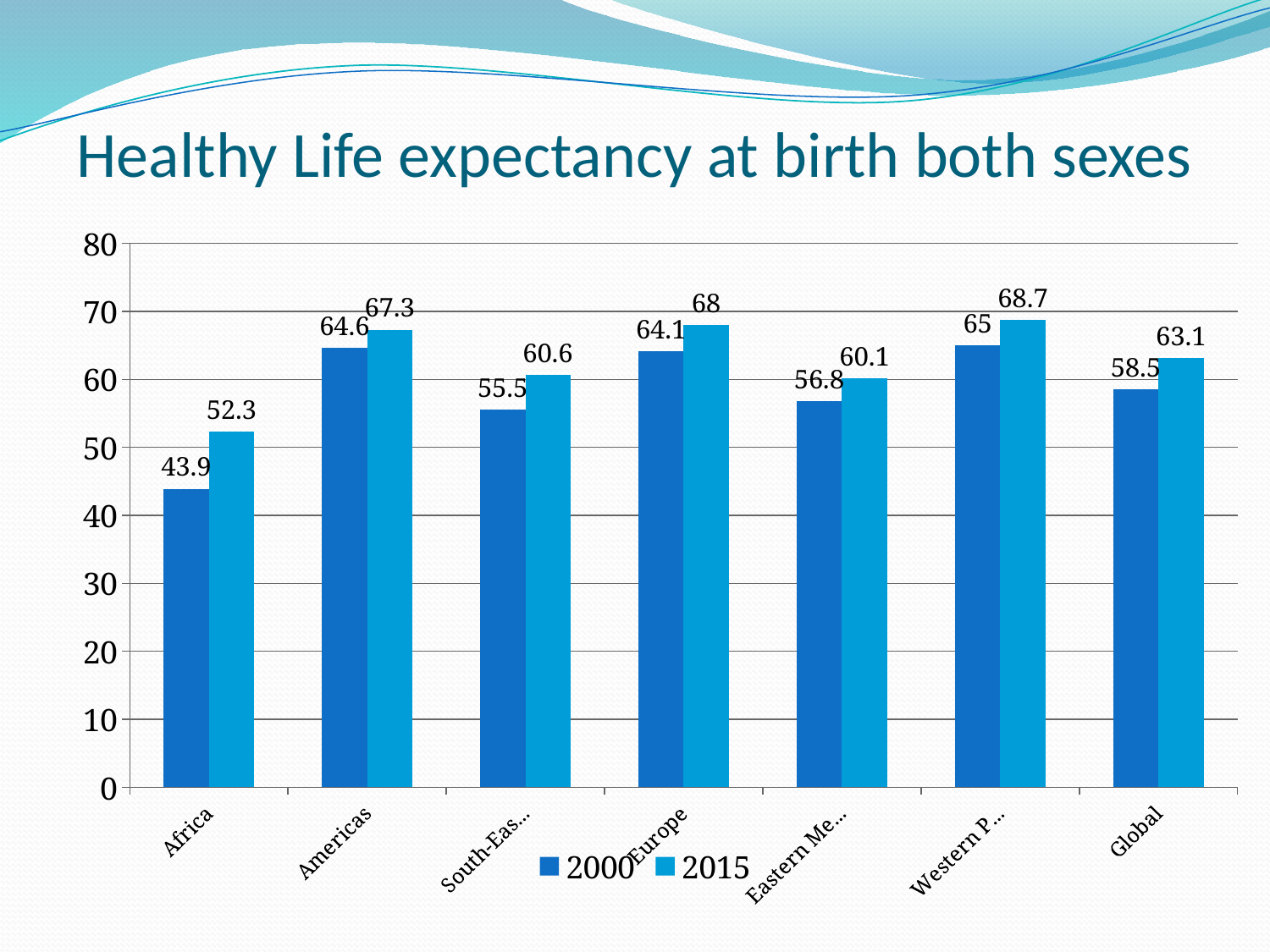
What is the 2015 value for Africa? 52.3 What is the 2015 value for Global? 63.1 What is the 2000 value for Europe? 64.1 What kind of chart is shown on the slide? bar chart Which is larger, the 2015 value for Americas or the 2015 value for Europe? Europe What is the difference between the 2015 and 2000 values for Africa? 8.4 How many categories are shown on the x axis? 7 Is the 2000 value for Global greater or less than 60? less What is the title of the chart? Healthy Life expectancy at birth both sexes How many series does the legend list? 2 Which category has the lowest 2015 value? Africa Which category has the lowest 2000 value? Africa